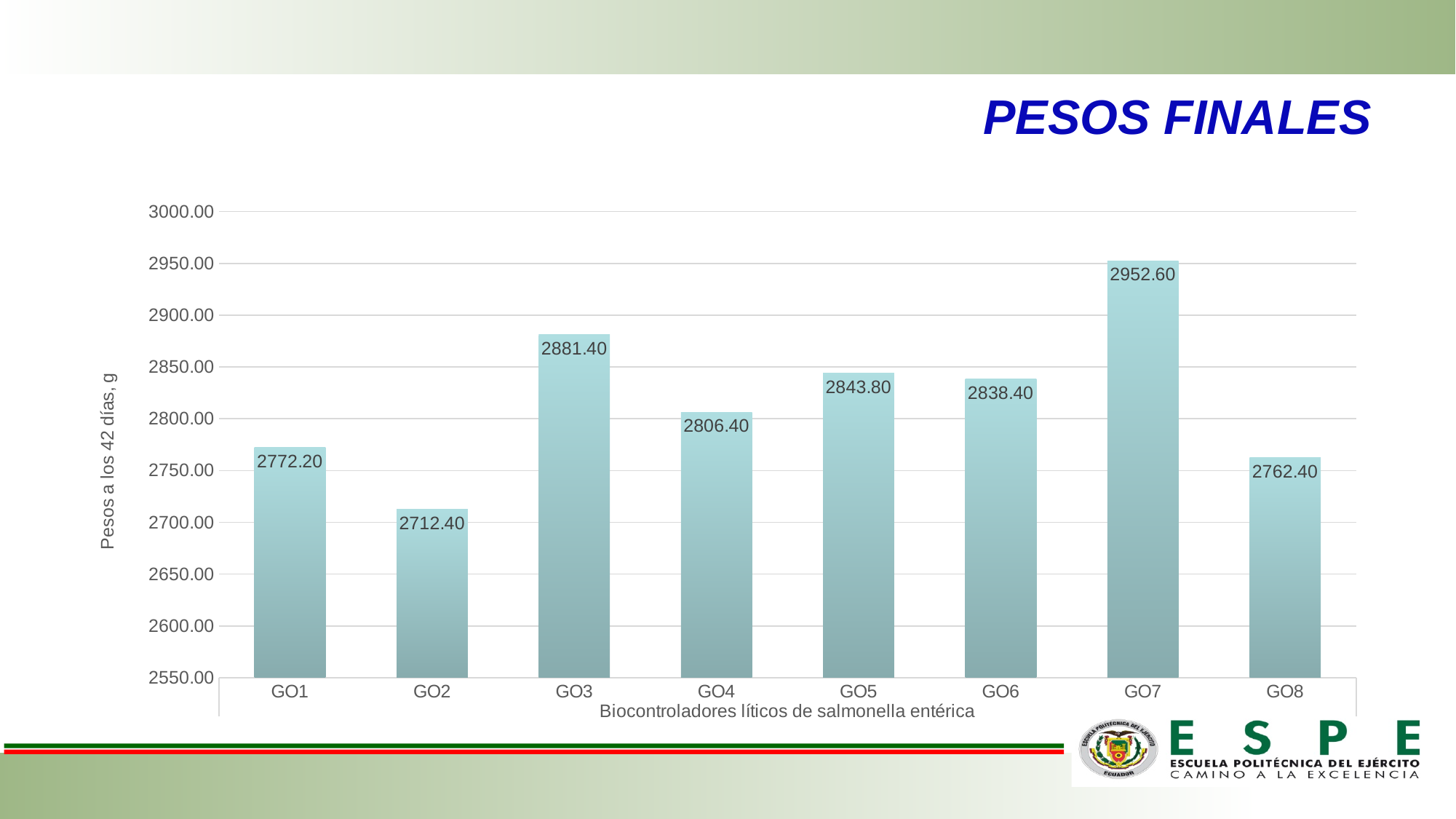
Which category has the lowest value? GO2 What kind of chart is shown on the slide? bar chart Which is larger, the value for GO1 or the value for GO4? GO4 What is the value for GO3? 2881.40 How many categories are shown on the x axis? 8 What is the value for GO8? 2762.40 What is the label of the y axis? Pesos a los 42 días, g Is the value for GO6 greater or less than 2800.00? greater What is the title of the slide? PESOS FINALES Which category has the highest value? GO7 What is the difference between the values for GO5 and GO6? 5.40 What is the difference between the values for GO7 and GO2? 240.20